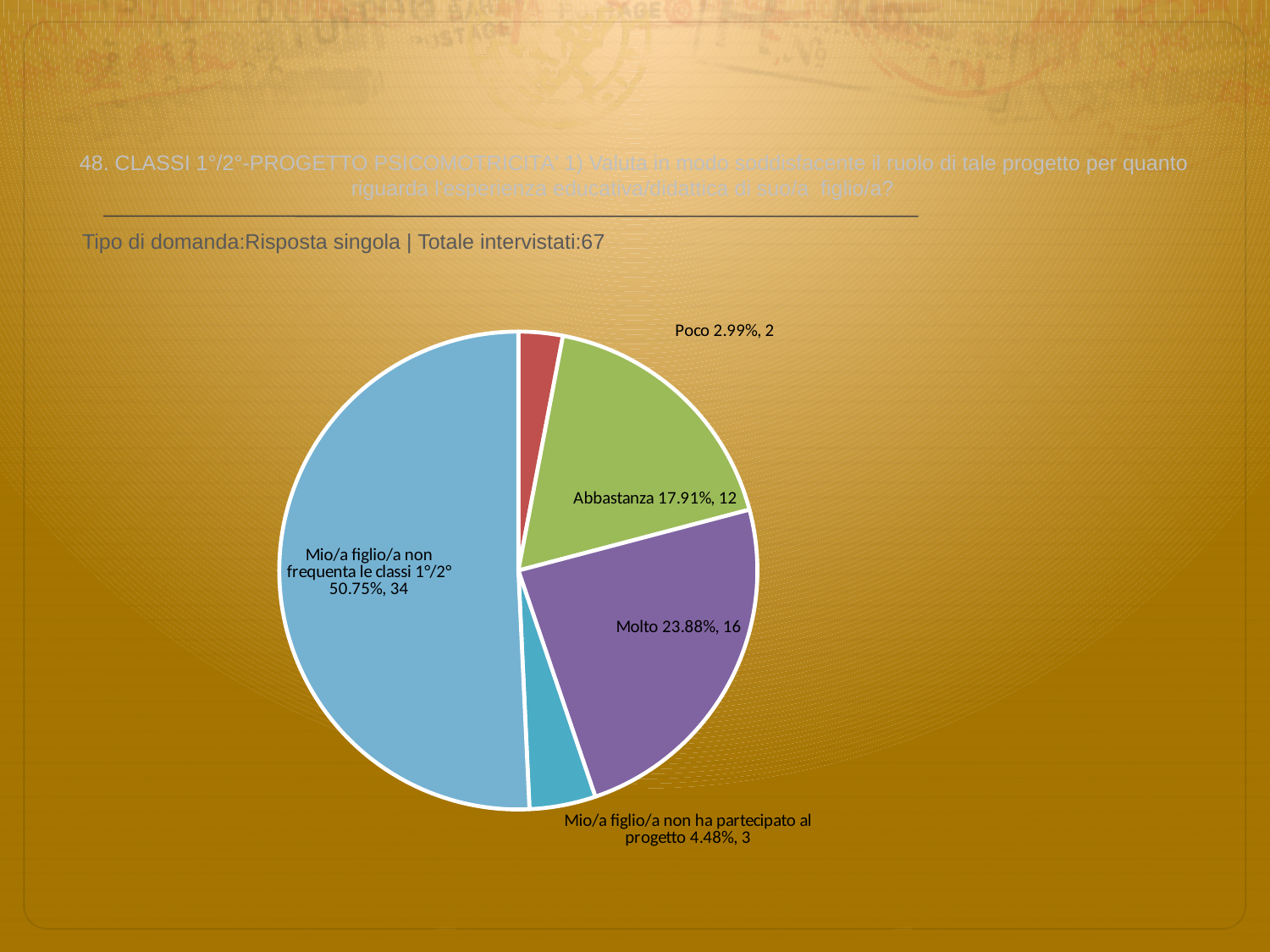
What percentage share does the 'Molto' slice have? 23.88% Which category has the smallest slice? Poco Which is larger, the 'Mio/a figlio/a non ha partecipato al progetto' slice or the 'Poco' slice? Mio/a figlio/a non ha partecipato al progetto How many respondents answered 'Abbastanza'? 12 What is the count for the 'Poco' slice? 2 How many slices does the pie chart have? 5 What is the total number of respondents stated on the slide? 67 Which category has the largest slice? Mio/a figlio/a non frequenta le classi 1°/2° What colour is the 'Molto' slice? purple What is the difference in count between 'Molto' and 'Abbastanza'? 4 What percentage share does the 'Mio/a figlio/a non frequenta le classi 1°/2°' slice have? 50.75% What kind of chart is shown on the slide? pie chart